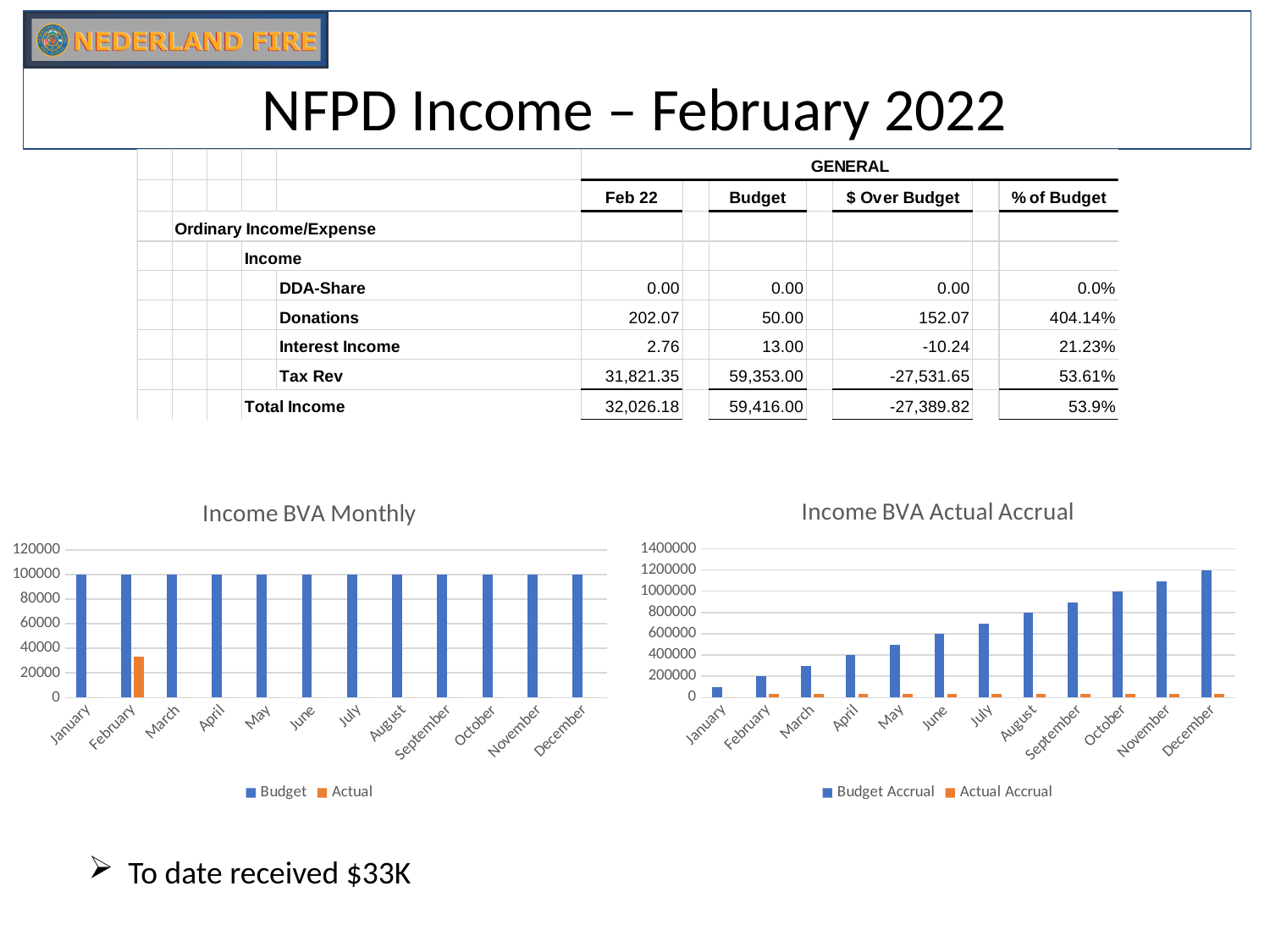
In the Income BVA Actual Accrual chart, do the Budget Accrual values rise or fall from January to December? Rise What kind of chart is the Income BVA Actual Accrual chart? Bar chart What colour are the Actual Accrual bars in the Income BVA Actual Accrual chart? Orange In the Income BVA Actual Accrual chart, which month has the highest Budget Accrual value? December How many months are shown on the x axis of the Income BVA Monthly chart? 12 In the Income BVA Monthly chart, is the Actual value for February greater or less than 20000? greater In the Income BVA Monthly chart, is the Actual value for February greater or less than 40000? less In the Income BVA Monthly chart, which is larger for February, Budget or Actual? Budget How many series does the legend of the Income BVA Monthly chart list? 2